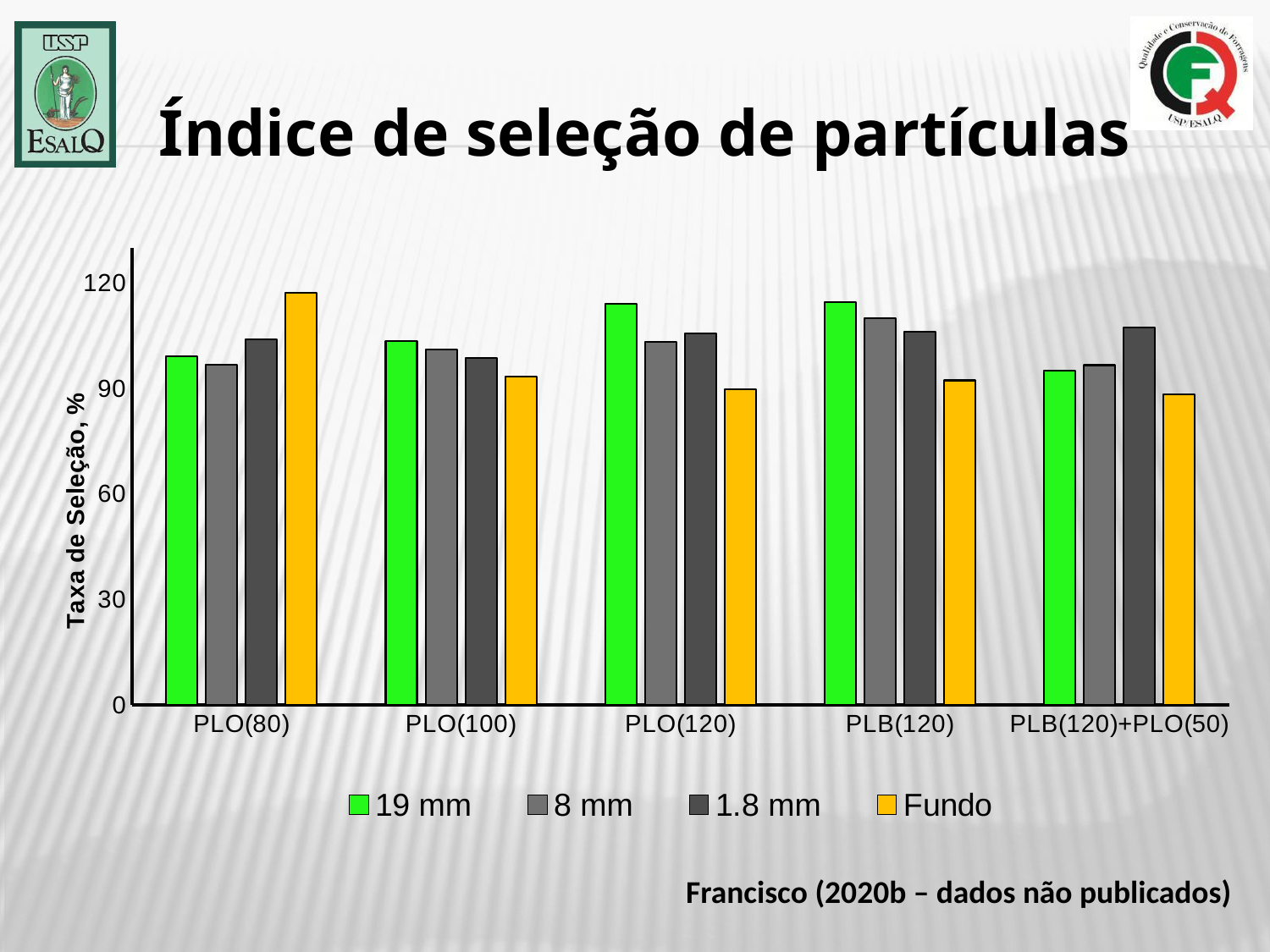
What kind of chart is shown on the slide? bar chart Is the value for Fundo at PLO(80) greater or less than 90? greater Which series has the lowest value for PLO(120)? Fundo Which is larger: the Fundo value for PLO(80) or the Fundo value for PLB(120)+PLO(50)? PLO(80) Is the value for 1.8 mm at PLB(120)+PLO(50) greater or less than 90? greater Is the value for 19 mm at PLB(120) greater or less than 120? less Which series has the highest value for PLB(120)+PLO(50)? 1.8 mm Which series has the highest value for PLO(80)? Fundo How many categories are shown on the x axis? 5 What is the title of the y axis? Taxa de Seleção, % Which series is shown in yellow in the legend? Fundo How many series does the legend list? 4